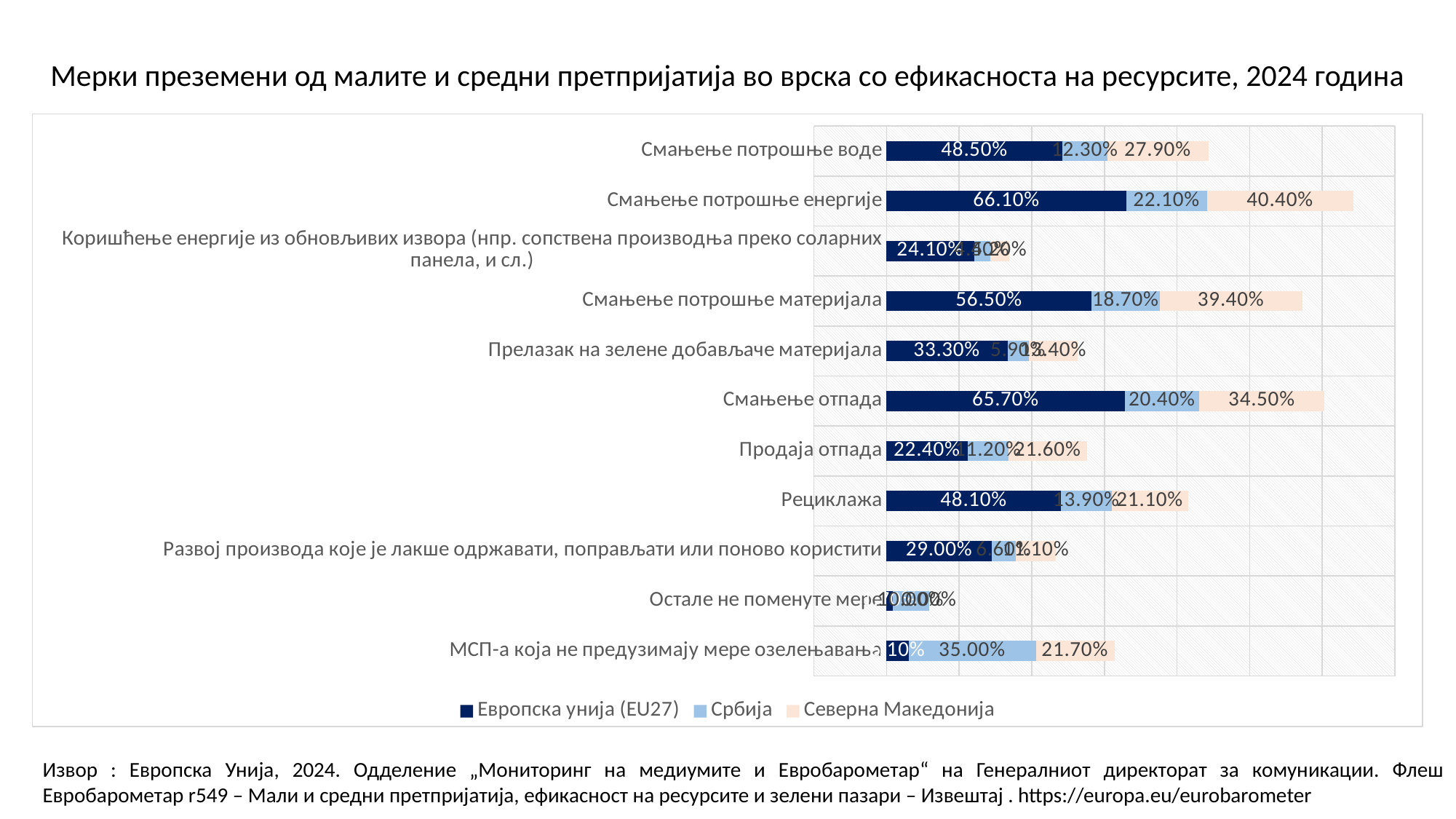
Which category has the highest value for Северна Македонија? Смањење потрошње енергије What kind of chart is shown on the slide? bar chart What is the total of the stacked bar for Смањење отпада? 120.60% What is the value for Северна Македонија for Смањење потрошње материјала? 39.40% Which category has the highest value for Европска унија (EU27)? Смањење потрошње енергије What is the value for Србија for Смањење отпада? 20.40% What is the value for Србија for МСП-а која не предузимају мере озелењавања? 35.00% How many categories (measures) are plotted on the chart? 11 How many series does the legend list? 3 What is the difference between the Европска унија (EU27) value and the Србија value for Рециклажа? 34.20% For Продаја отпада, which is larger: the value for Србија or the value for Северна Македонија? Северна Македонија What is the value for Европска унија (EU27) for Смањење потрошње енергије? 66.10%